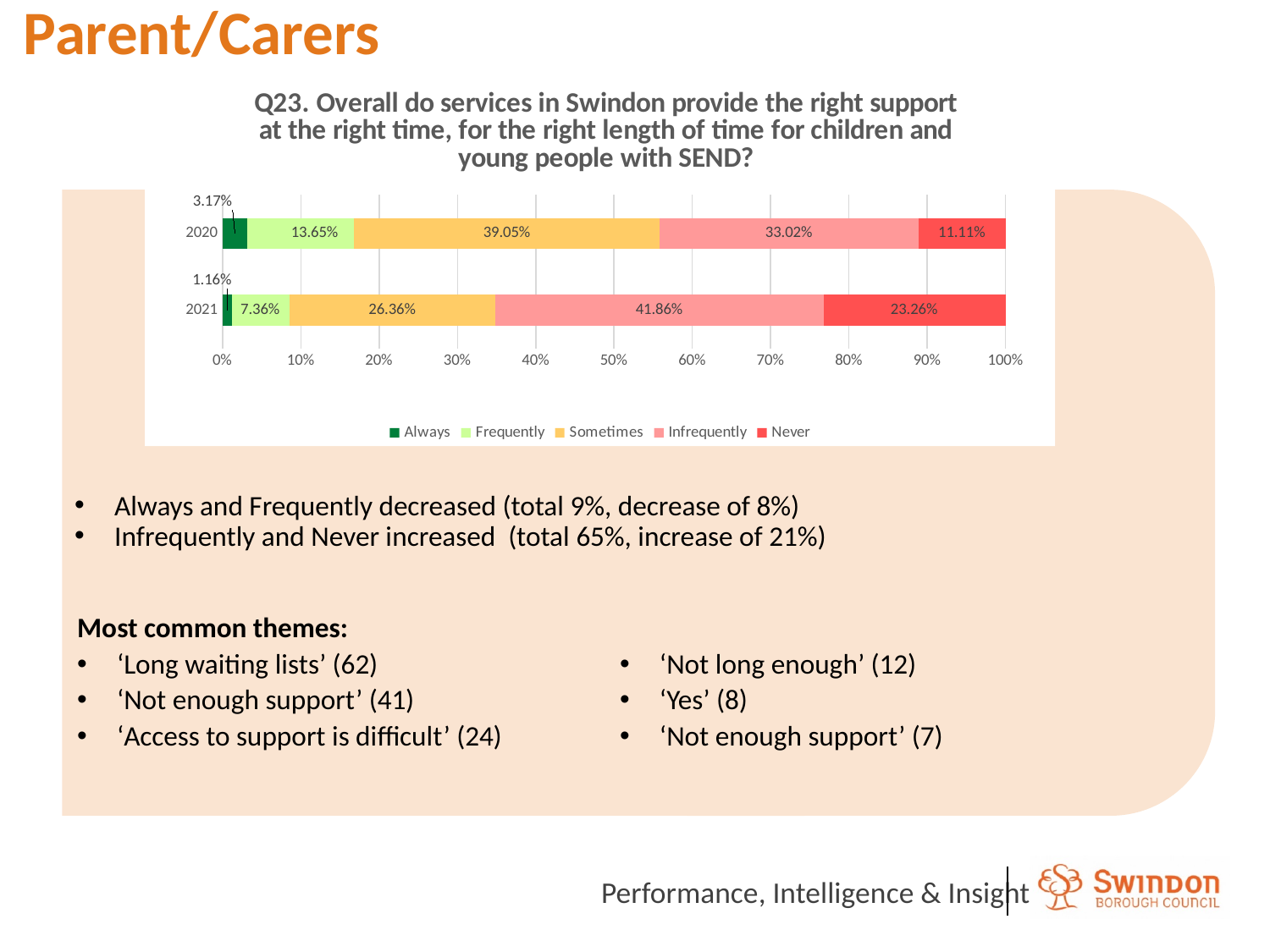
What is the value for 'Always' in 2021? 1.16% What is the value for 'Infrequently' in 2020? 33.02% What percentage of 2021 responses were 'Never'? 23.26% How many years (bars) are shown in the chart? 2 By how many percentage points did the 'Never' share change from 2020 to 2021? 12.15 percentage points How many series does the legend list? 5 What type of chart is shown on the slide? Stacked bar chart Is the 'Frequently' share larger in 2020 or in 2021? 2020 Which response category has the largest share in the 2021 bar? Infrequently What percentage of 2020 responses were 'Sometimes'? 39.05% Which response category has the largest share in the 2020 bar? Sometimes Which response category has the smallest share in the 2020 bar? Always